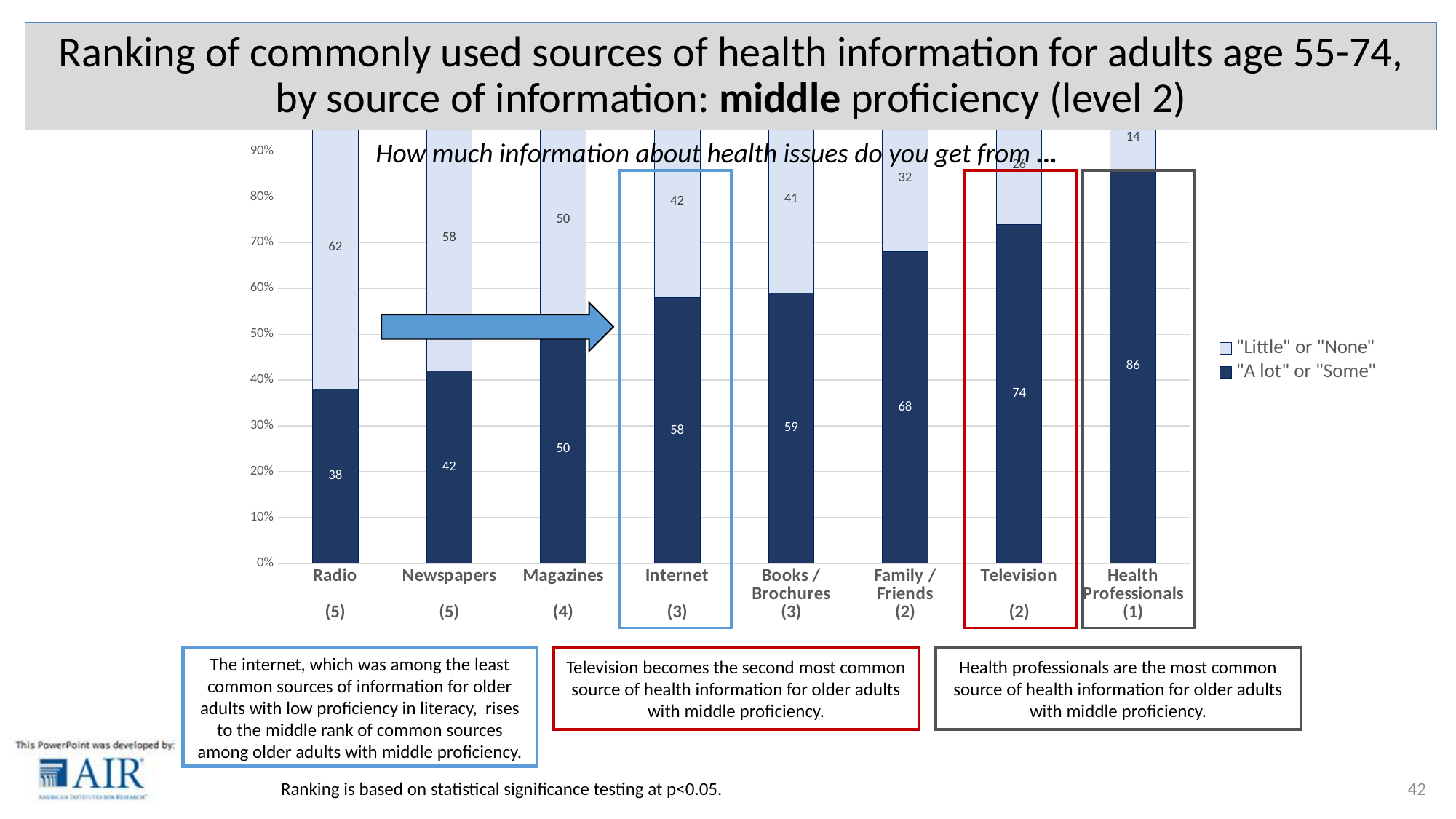
How many series does the legend list? 2 What is the "Little" or "None" value for Radio? 62 Which has a larger "A lot" or "Some" value, Internet or Family / Friends? Family / Friends What is the "A lot" or "Some" value for Television? 74 What is the "Little" or "None" value for Health Professionals? 14 What is the "A lot" or "Some" value for Books / Brochures? 59 Which source has the lowest "A lot" or "Some" value? Radio How many sources of information are shown on the x axis? 8 What is the difference between the "A lot" or "Some" values for Health Professionals and Television? 12 What kind of chart is shown on the slide? Stacked bar chart Which source has the highest "A lot" or "Some" value? Health Professionals Do the "A lot" or "Some" values rise or fall from Radio to Health Professionals along the x axis? Rise